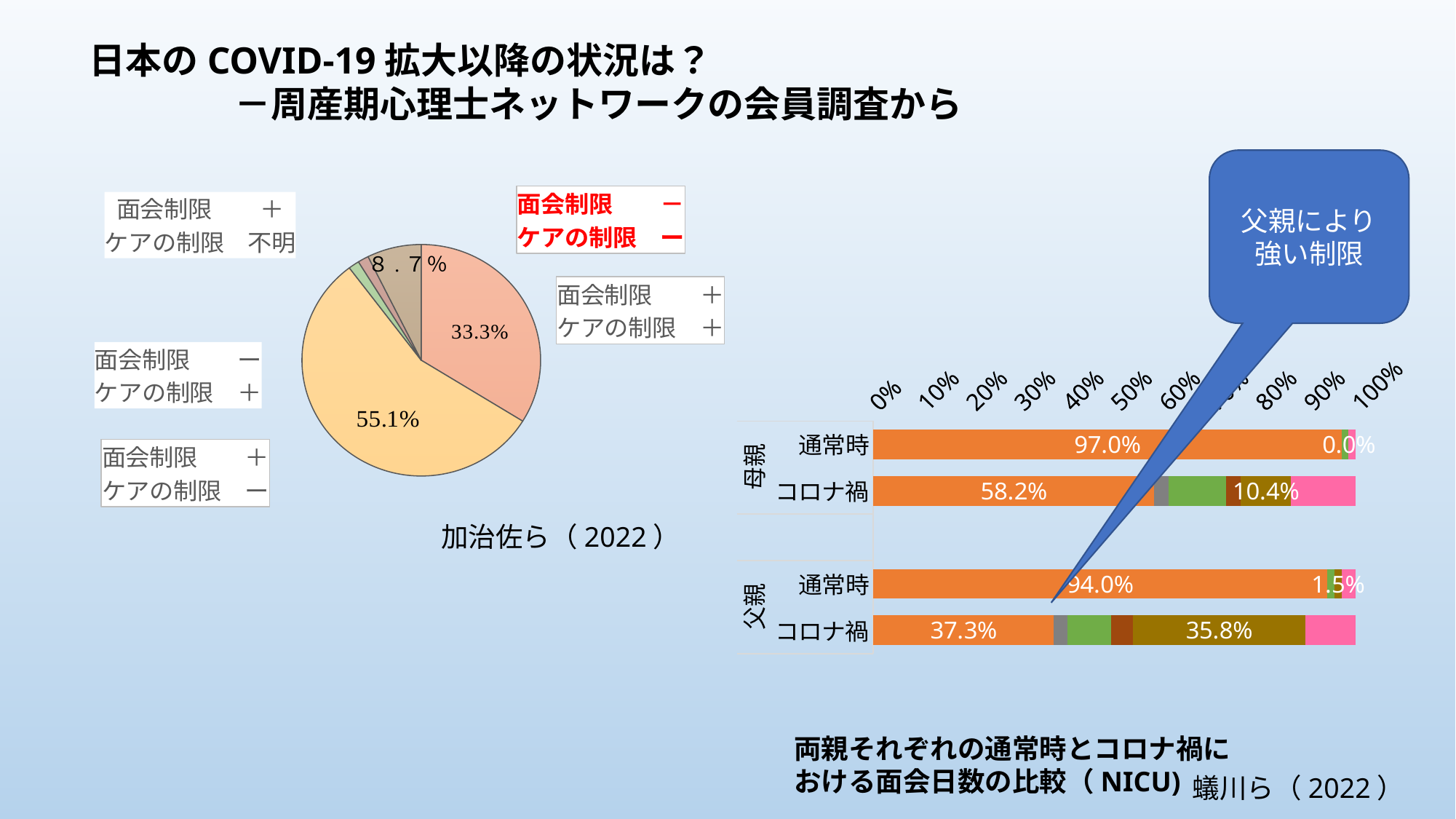
In the bar chart on the right, what is the value of the orange segment for 母親 コロナ禍? 58.2% In the bar chart on the right, what is the value of the orange segment for 母親 通常時? 97.0% What type of chart is the chart on the right of the slide (蟻川ら 2022)? bar chart In the bar chart on the right, what is the value of the orange segment for 父親 コロナ禍? 37.3% In the pie chart on the left, what percentage is shown for the slice labelled 面会制限＋ / ケアの制限＋? 33.3% In the bar chart on the right, how many bars are plotted? 4 In the pie chart on the left, what percentage is shown for the slice labelled 面会制限－ / ケアの制限－ (the red label)? 8.7% In the pie chart on the left, what is the difference between the 55.1% slice and the 33.3% slice? 21.8 percentage points In the pie chart on the left, what is the value of the largest slice? 55.1% In the bar chart on the right, what is the value of the olive segment for 父親 コロナ禍? 35.8% In the bar chart on the right, which has the larger orange segment: 母親 コロナ禍 or 父親 コロナ禍? 母親 コロナ禍 What type of chart is the chart on the left of the slide (加治佐ら 2022)? pie chart